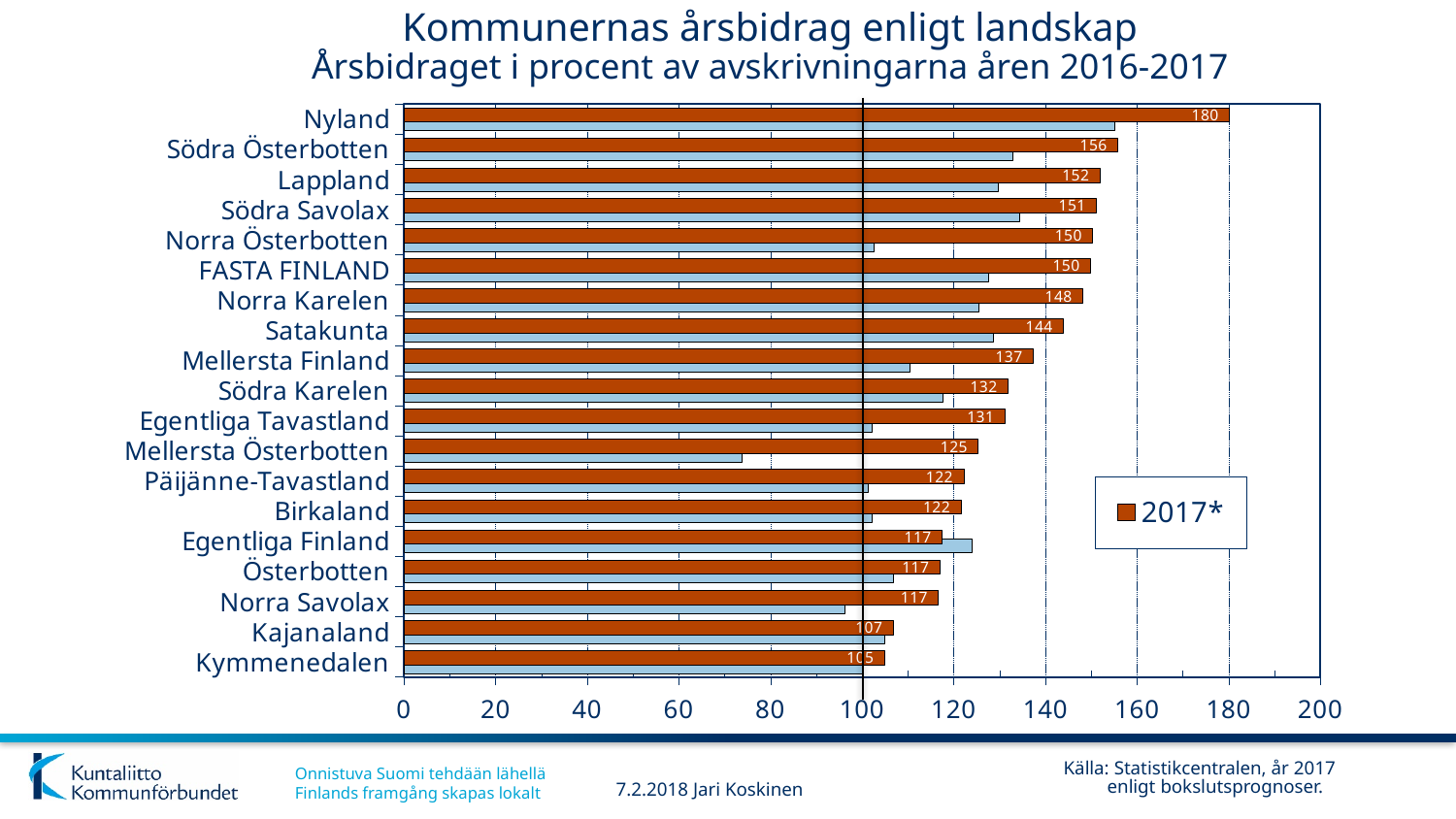
Is the light blue bar for Mellersta Österbotten greater or less than 80? less Which landskap has the highest 2017* value? Nyland Which has a larger 2017* value, Lappland or Mellersta Finland? Lappland What is the difference between the 2017* values for Nyland and Södra Österbotten? 24 What kind of chart is shown on the slide? Bar chart What is the 2017* value for Kymmenedalen? 105 What is the 2017* value for Nyland? 180 Which landskap has the lowest 2017* value? Kymmenedalen Is the light blue bar for Norra Savolax greater or less than 100? less How many series does the legend list? 1 What is the 2017* value for Satakunta? 144 How many landskap categories are shown on the chart? 19